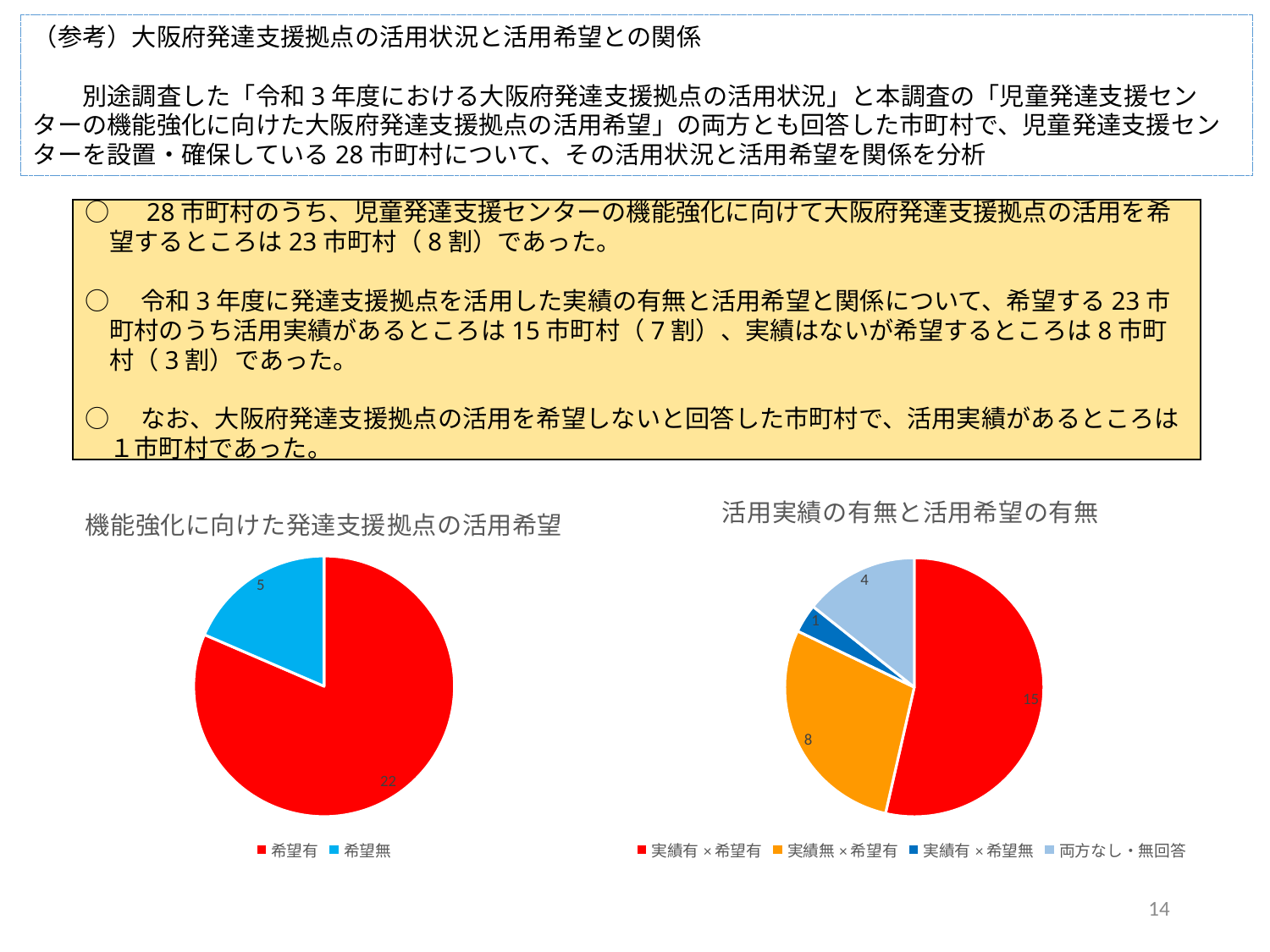
In the right pie chart (活用実績の有無と活用希望の有無), which category has the largest value? 実績有×希望有 How many slices does the left pie chart (機能強化に向けた発達支援拠点の活用希望) have? 2 In the left pie chart (機能強化に向けた発達支援拠点の活用希望), what is the difference between 希望有 and 希望無? 17 In the right pie chart (活用実績の有無と活用希望の有無), what is the value for 実績無×希望有? 8 In the right pie chart (活用実績の有無と活用希望の有無), which category has the smallest value? 実績有×希望無 In the left pie chart (機能強化に向けた発達支援拠点の活用希望), what is the value for 希望無? 5 How many categories does the legend of the right pie chart (活用実績の有無と活用希望の有無) list? 4 In the left pie chart (機能強化に向けた発達支援拠点の活用希望), what is the value for 希望有? 22 What type of chart is the left chart (機能強化に向けた発達支援拠点の活用希望)? Pie chart In the right pie chart (活用実績の有無と活用希望の有無), what is the total of all slices? 28 In the right pie chart (活用実績の有無と活用希望の有無), what is the value for 両方なし・無回答? 4 In the right pie chart (活用実績の有無と活用希望の有無), what is the value for 実績有×希望有? 15